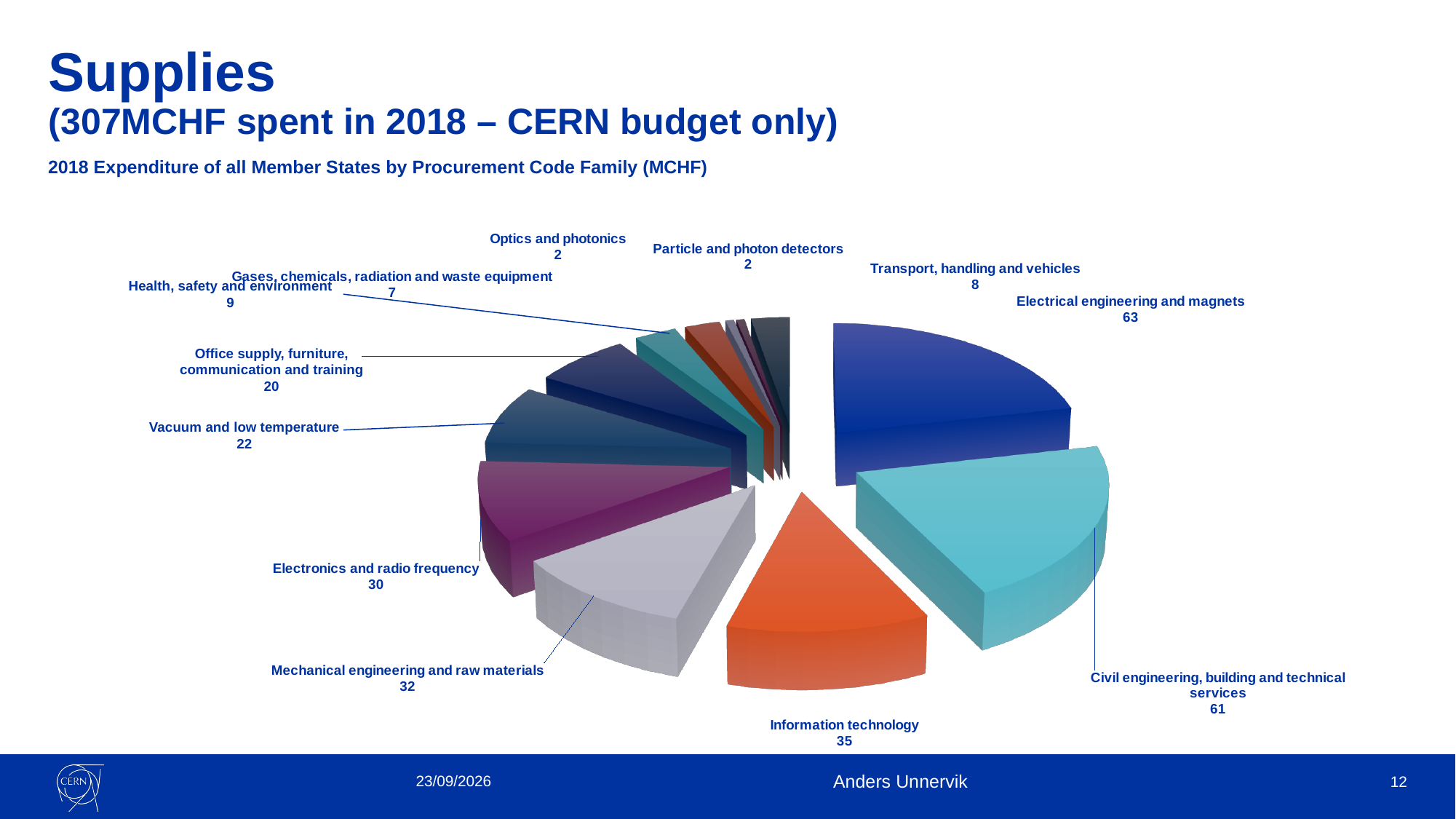
How many procurement code families are shown in the pie chart? 12 Which is larger, Health, safety and environment or Transport, handling and vehicles? Health, safety and environment What is the value for Electrical engineering and magnets? 63 What is the value for Vacuum and low temperature? 22 What is the value for Information technology? 35 What is the value for Gases, chemicals, radiation and waste equipment? 7 What is the title of the chart? 2018 Expenditure of all Member States by Procurement Code Family (MCHF) Which procurement code family has the highest expenditure? Electrical engineering and magnets What is the difference between Electrical engineering and magnets and Civil engineering, building and technical services? 2 What type of chart is shown on the slide? Pie chart Which is larger, Mechanical engineering and raw materials or Office supply, furniture, communication and training? Mechanical engineering and raw materials What is the difference between Information technology and Electronics and radio frequency? 5